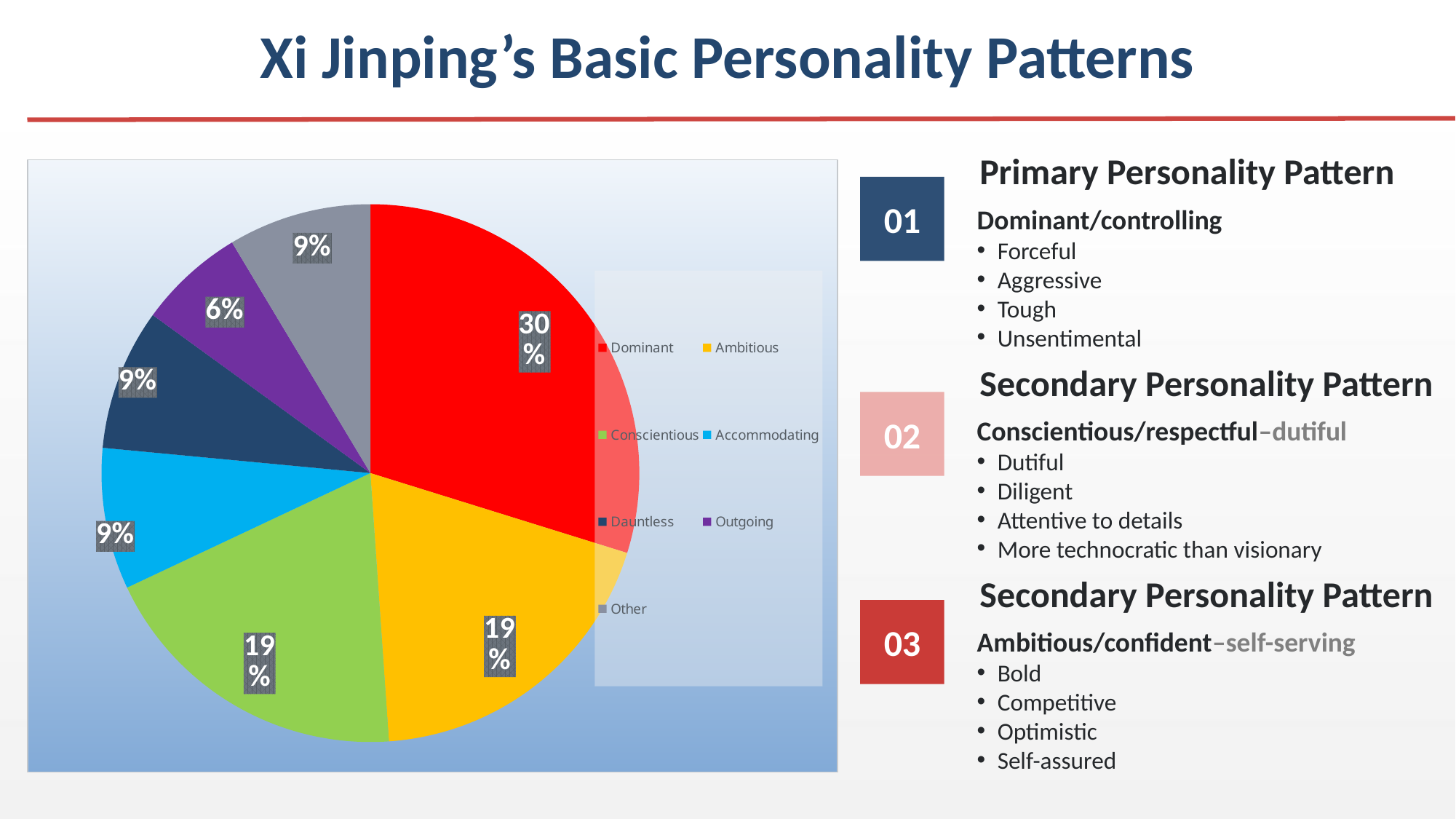
What is the value shown for the Ambitious slice? 19% Which category has the largest slice of the pie? Dominant Which category has the smallest slice of the pie? Outgoing What is the difference between the Dominant and Ambitious values? 11% How many entries does the chart legend list? 7 What is the value shown for the Outgoing slice? 6% What is the value shown for the Conscientious slice? 19% What share of the pie does the Dominant slice represent? 30% What is the value shown for the Accommodating slice? 9% Which is larger, the Dauntless slice or the Outgoing slice? Dauntless What kind of chart is shown on the slide? pie chart What colour is the Dominant slice in the pie chart? red